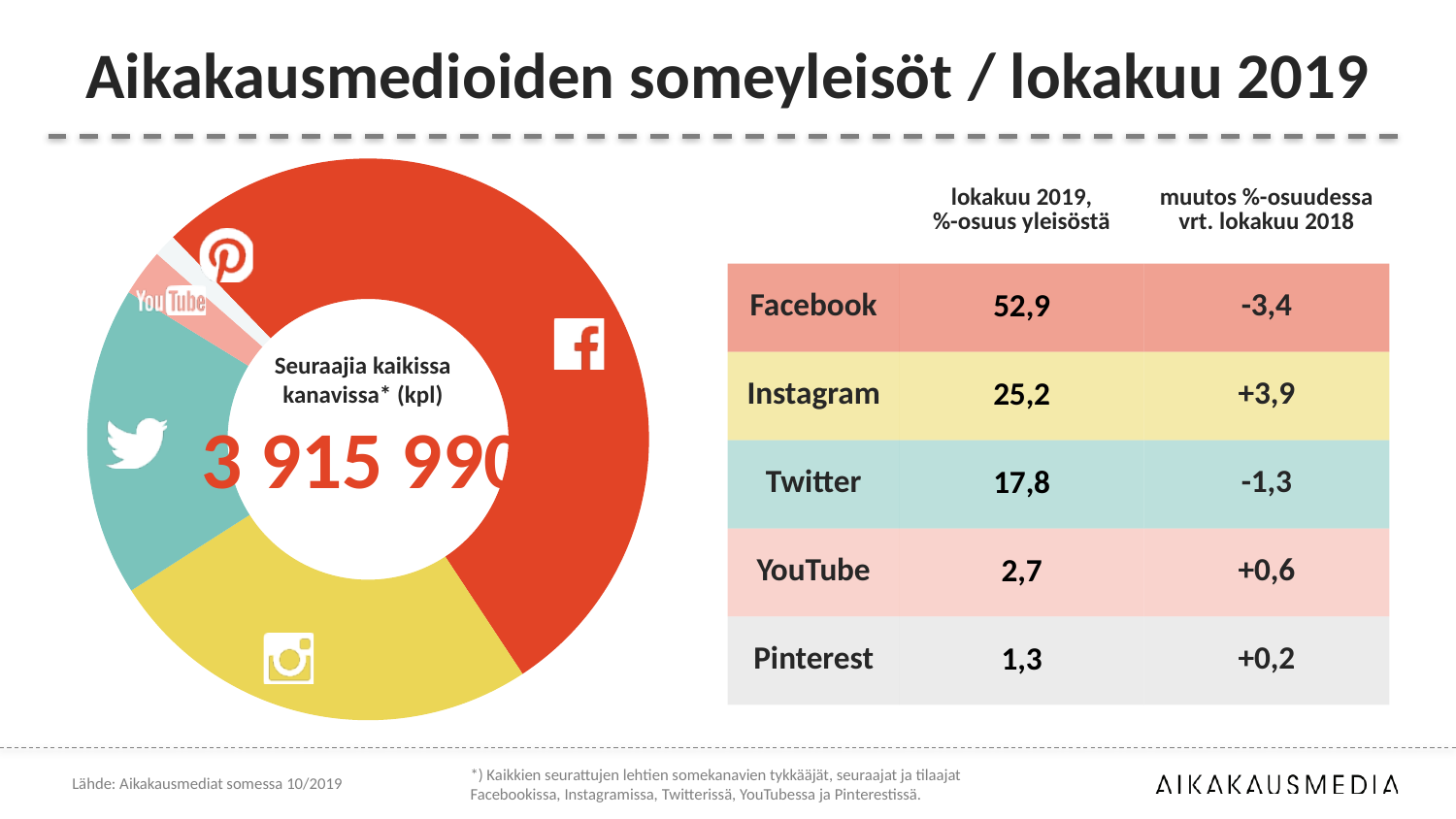
What is the difference between Facebook's and Instagram's share of the audience in October 2019? 27,7 Which channel has the largest slice of the donut chart? Facebook What is Facebook's share of the audience in October 2019 (lokakuu 2019, %-osuus yleisöstä)? 52,9 What is the change in percentage share for Instagram compared to October 2018 (muutos %-osuudessa vrt. lokakuu 2018)? +3,9 Which has a larger share of the audience, Twitter or YouTube? Twitter Which channel has the smallest slice of the donut chart? Pinterest What kind of chart is shown on the left of the slide? Pie chart (donut) What total number of followers across all channels (Seuraajia kaikissa kanavissa) is shown in the centre of the donut chart? 3 915 990 What is the change in percentage share for Facebook compared to October 2018? -3,4 How many slices does the donut chart have? 5 What is Twitter's share of the audience in October 2019? 17,8 What is Instagram's share of the audience in October 2019? 25,2